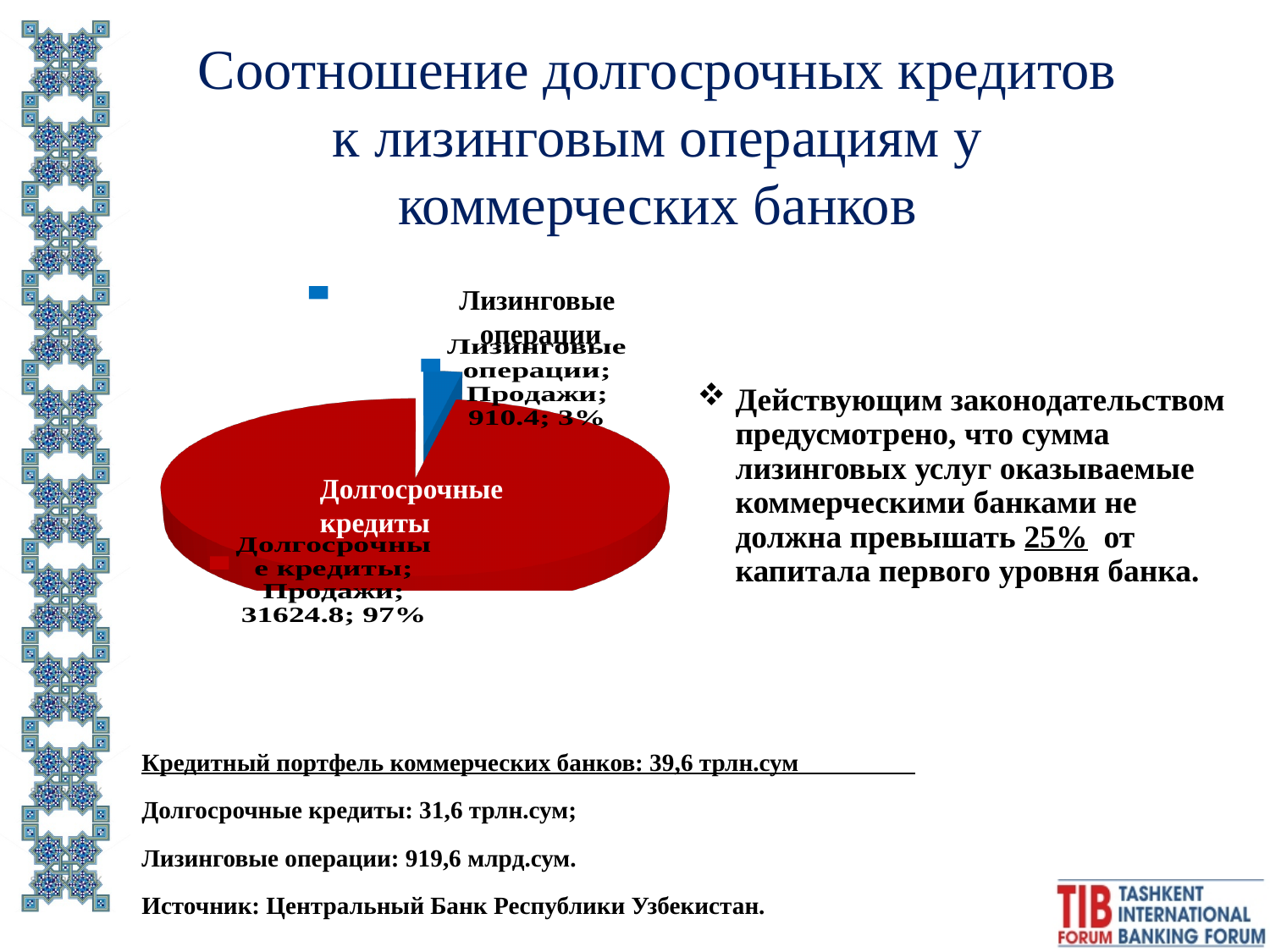
What share of the pie does the slice "Долгосрочные кредиты" represent? 97% What value is printed on the data label for "Долгосрочные кредиты"? 31624.8 What kind of chart is shown on the slide? pie chart Which slice of the pie chart is the smallest? Лизинговые операции What colour is the slice for "Долгосрочные кредиты" in the pie chart? red What value is printed on the data label for "Лизинговые операции"? 910.4 What is the difference in percentage points between the shares of "Долгосрочные кредиты" and "Лизинговые операции"? 94 percentage points What share of the pie does the slice "Лизинговые операции" represent? 3% What colour is the slice for "Лизинговые операции" in the pie chart? blue How many slices does the pie chart have? 2 Which slice of the pie chart is the largest? Долгосрочные кредиты Which is larger, the slice for "Долгосрочные кредиты" or the slice for "Лизинговые операции"? Долгосрочные кредиты